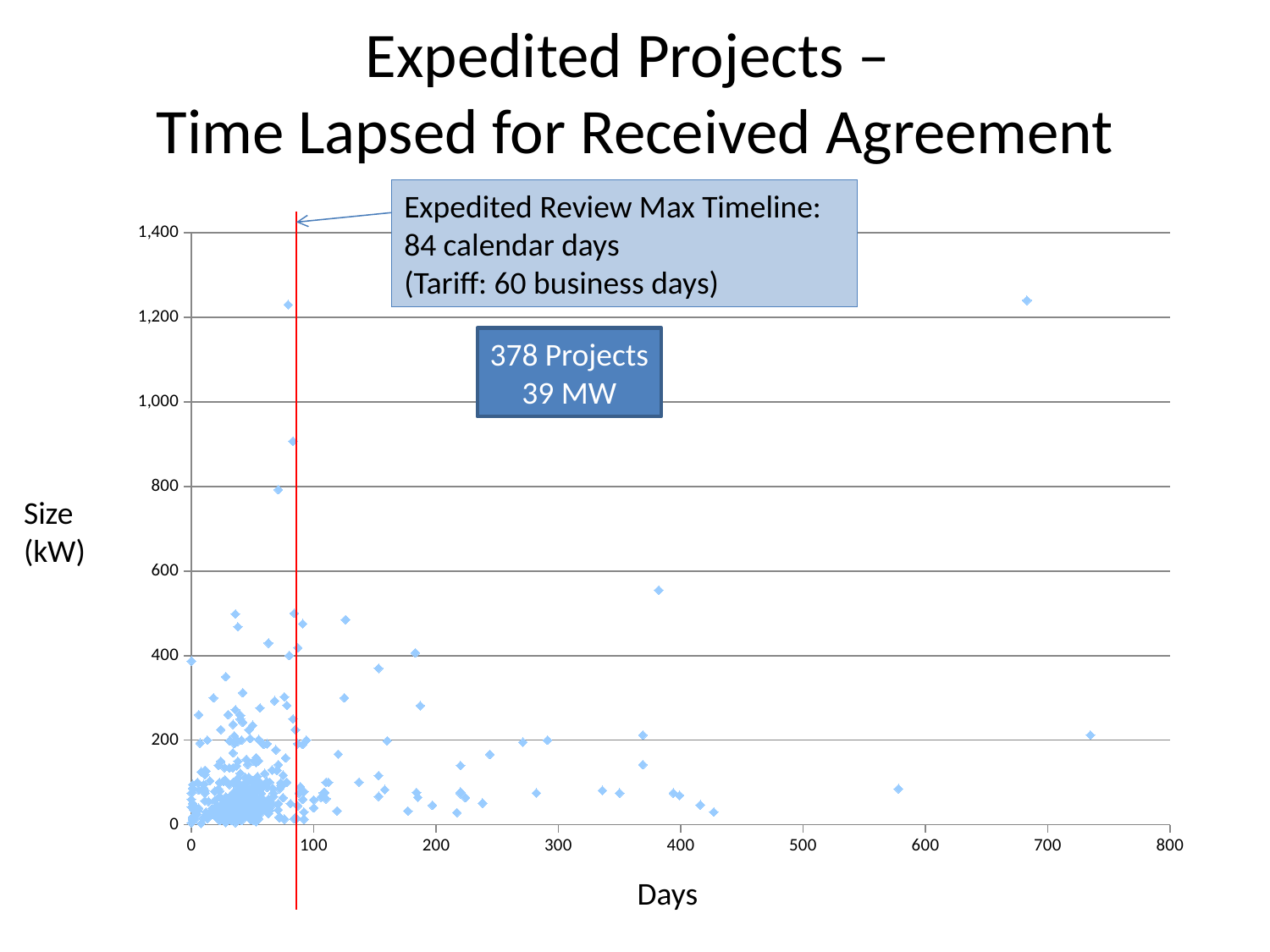
What is the title of the x axis of the chart? Days Is the size of the project with the largest Days value (around 735 days) greater or less than 400 kW? less Is the size of the highest plotted point (near 80 days) greater or less than 1,000 kW? greater Is the size of the project plotted at roughly 680 days greater or less than 1,400 kW? less What kind of chart is shown on the slide? scatter chart What is the title of the y axis of the chart? Size (kW)